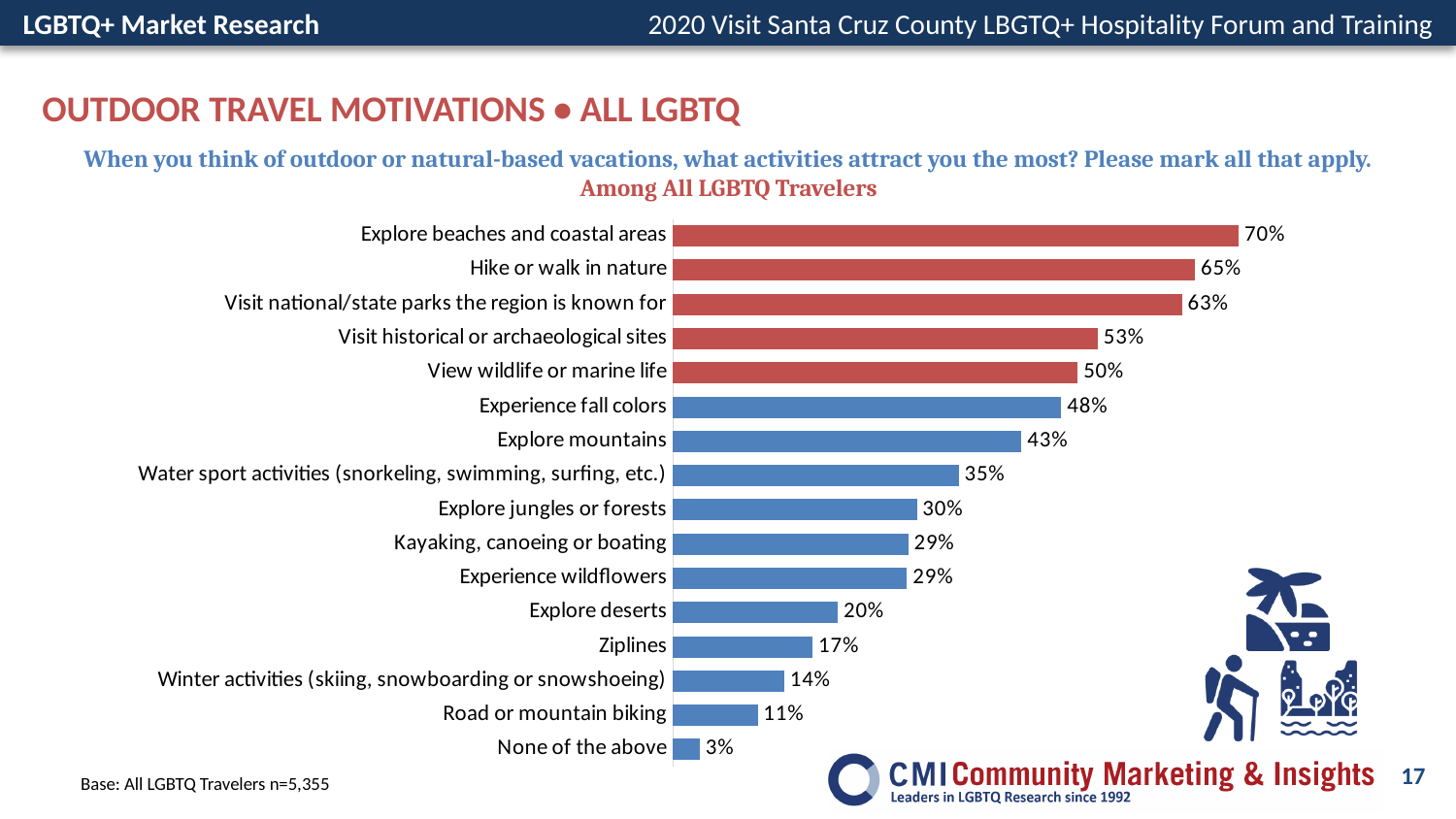
What is the difference between 'Hike or walk in nature' and 'Explore mountains'? 22% Which is larger: 'Experience fall colors' or 'Water sport activities (snorkeling, swimming, surfing, etc.)'? Experience fall colors What is the difference between 'Explore deserts' and 'Road or mountain biking'? 9% Which activity has the highest percentage? Explore beaches and coastal areas What is the base sample size stated on the slide? n=5,355 What kind of chart is shown on the slide? Bar chart What percentage of LGBTQ travelers selected 'Explore beaches and coastal areas'? 70% What is the value for 'Kayaking, canoeing or boating'? 29% How many categories have bars colored red? 5 Which category has the lowest percentage? None of the above What percentage selected 'Winter activities (skiing, snowboarding or snowshoeing)'? 14% How many categories are shown in the chart? 16